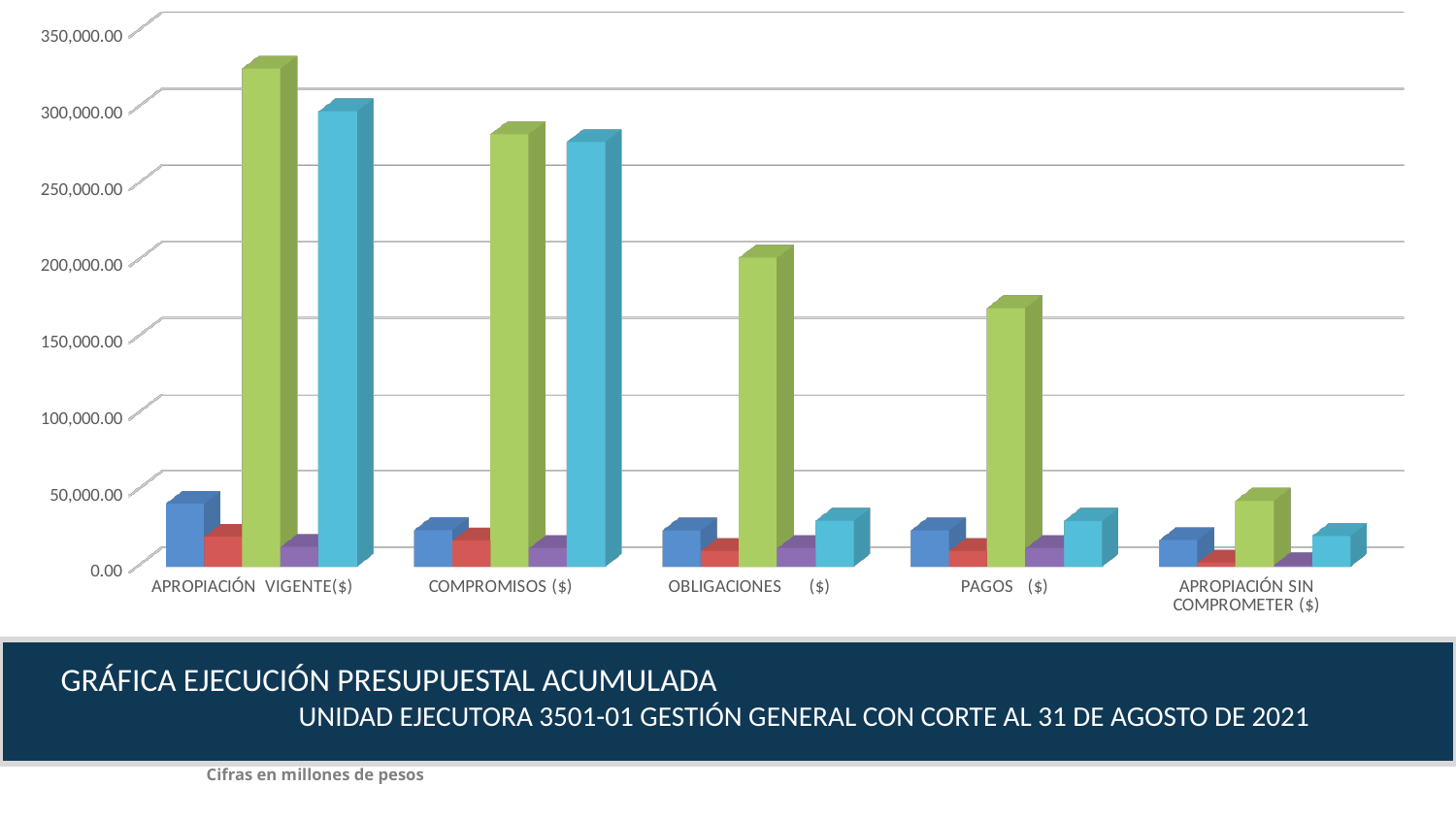
Which green bar is taller: OBLIGACIONES ($) or PAGOS ($)? OBLIGACIONES ($) Is the green bar for APROPIACIÓN VIGENTE($) greater or less than 300,000.00? greater Is the green bar for PAGOS ($) greater or less than 200,000.00? less According to the note below the chart, in what units are the figures expressed? millones de pesos What kind of chart is shown on the slide? bar chart Is the light blue bar for COMPROMISOS ($) greater or less than 250,000.00? greater How many categories are shown on the x axis of the chart? 5 Which category has the shortest green bar? APROPIACIÓN SIN COMPROMETER ($) Which category has the tallest green bar? APROPIACIÓN VIGENTE($) How many bars are plotted for each category in the chart? 5